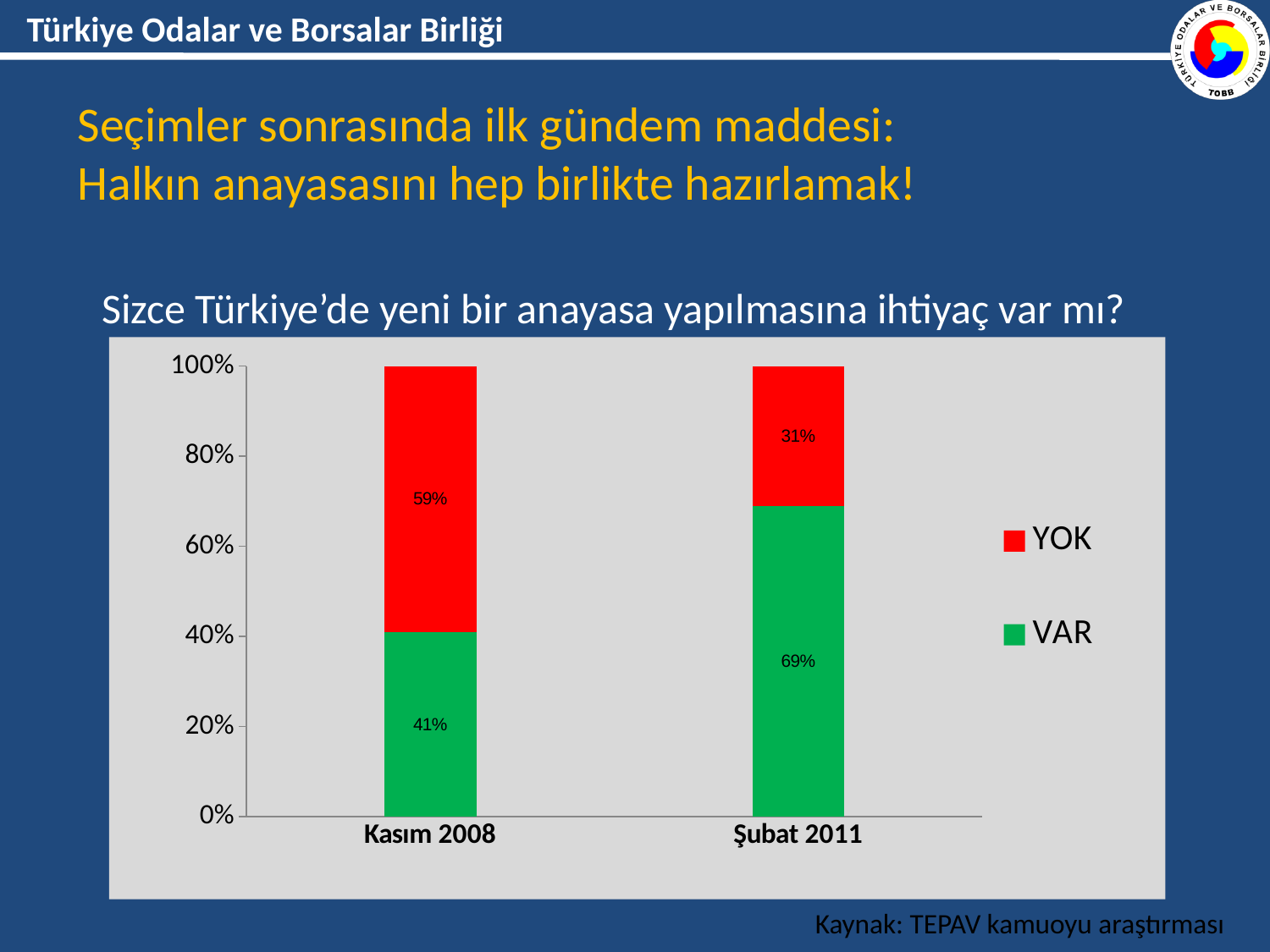
Which category has the highest VAR value? Şubat 2011 Which is larger for Kasım 2008, VAR or YOK? YOK What is the YOK value for Kasım 2008? 59% What is the difference between the VAR values for Şubat 2011 and Kasım 2008? 28% How many series does the legend list? 2 What is the VAR value for Kasım 2008? 41% What kind of chart is shown? stacked bar chart What is the YOK value for Şubat 2011? 31% What is the VAR value for Şubat 2011? 69% Which category has the lowest YOK value? Şubat 2011 How many categories are shown on the x axis? 2 Which colour represents the VAR series? green